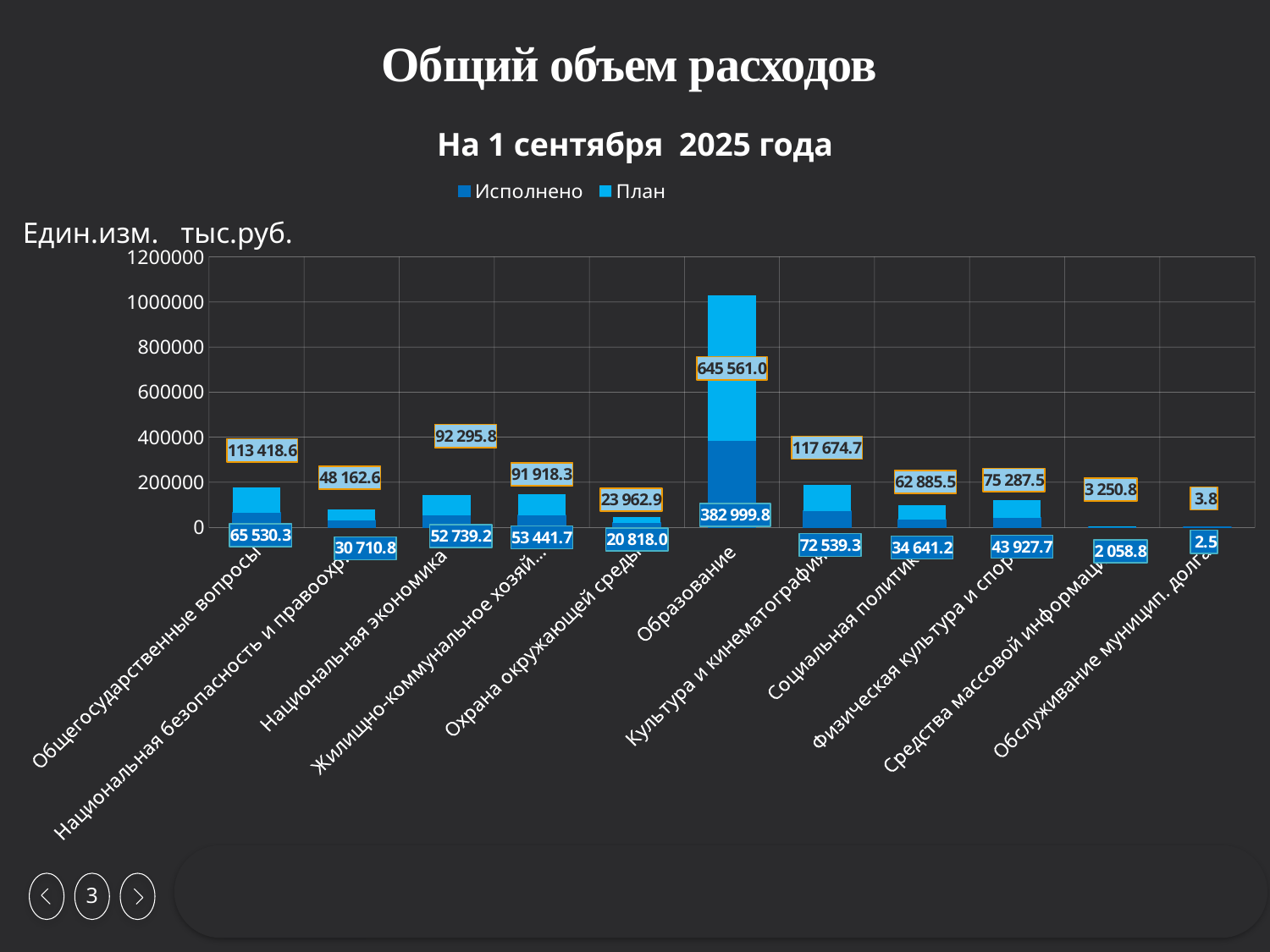
Which category has the highest Исполнено value? Образование What is the План value for Образование? 645 561.0 What is the Исполнено value for Образование? 382 999.8 What is the Исполнено value for Национальная экономика? 52 739.2 What kind of chart is shown on the slide? Bar chart Which has the larger Исполнено value: Культура и кинематография or Общегосударственные вопросы? Культура и кинематография What is the План value for Общегосударственные вопросы? 113 418.6 How many series does the legend list? 2 Which category has the lowest План value? Обслуживание муницип. долга What is the Исполнено value for Охрана окружающей среды? 20 818.0 How many categories are shown on the x axis? 11 What is the difference between the План and Исполнено values for Социальная политика? 28 244.3